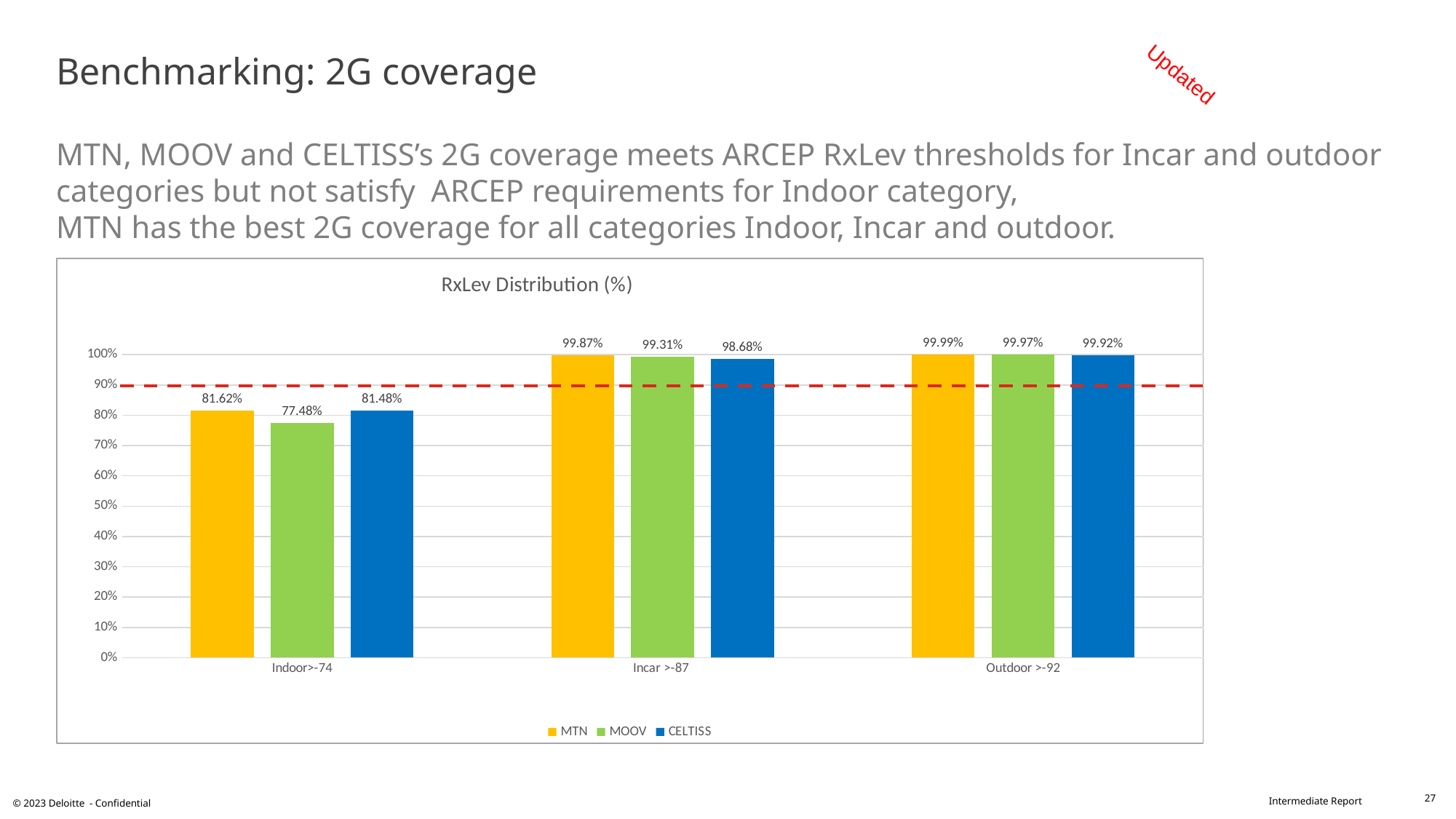
Which operator has the lowest value in the Indoor>-74 category? MOOV How many series does the legend list? 3 What kind of chart is shown on the slide? bar chart How many categories are shown on the x axis? 3 Which operator has the highest value in the Outdoor >-92 category? MTN What is the difference between MTN and MOOV in the Indoor>-74 category? 4.14% What is the title of the chart? RxLev Distribution (%) What is the RxLev value for MOOV in the Incar >-87 category? 99.31% Which is larger in the Incar >-87 category: MOOV or CELTISS? MOOV Is the value for CELTISS in the Indoor>-74 category greater or less than 90%? less What is the RxLev value for MTN in the Indoor>-74 category? 81.62% What is the RxLev value for CELTISS in the Outdoor >-92 category? 99.92%